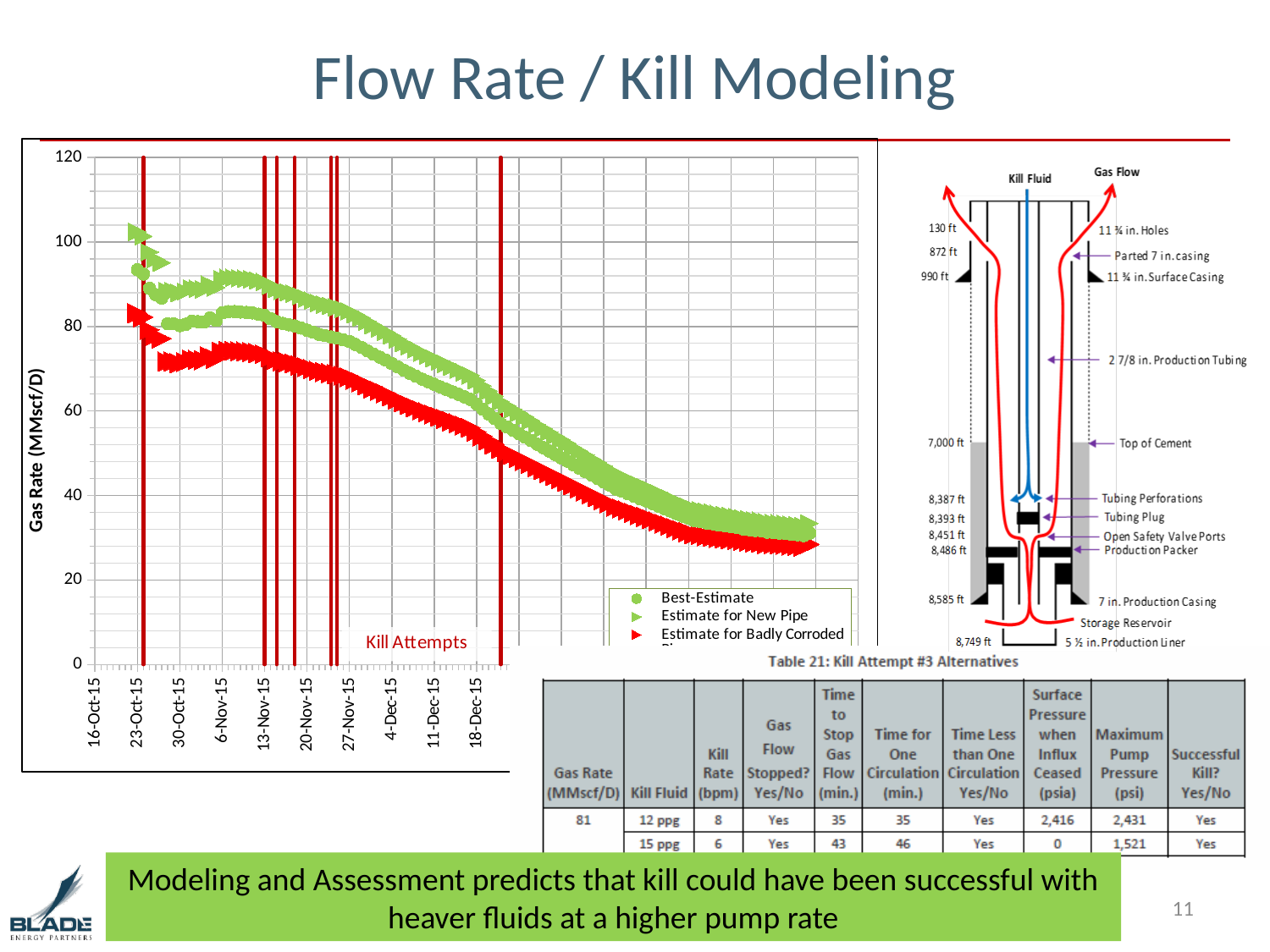
Around 6-Nov-15, which is larger: the Estimate for New Pipe or the Estimate for Badly Corroded Pipe? Estimate for New Pipe Is the Best-Estimate value at 23-Oct-15 greater or less than 80? greater Is the Estimate for Badly Corroded Pipe value at 6-Nov-15 greater or less than 80? less What is the title of the vertical axis of the gas rate chart? Gas Rate (MMscf/D) Do the gas rate values rise or fall from 16-Oct-15 to 18-Dec-15? fall Is the Estimate for New Pipe value at 18-Dec-15 greater or less than 60? greater Which series has the highest gas rate values throughout the chart? Estimate for New Pipe Which series has the lowest gas rate values throughout the chart? Estimate for Badly Corroded Pipe How many series does the legend of the gas rate chart list? 3 What do the red vertical lines on the gas rate chart represent, according to the label on the chart? Kill Attempts What kind of chart is shown on the left of the slide? scatter chart